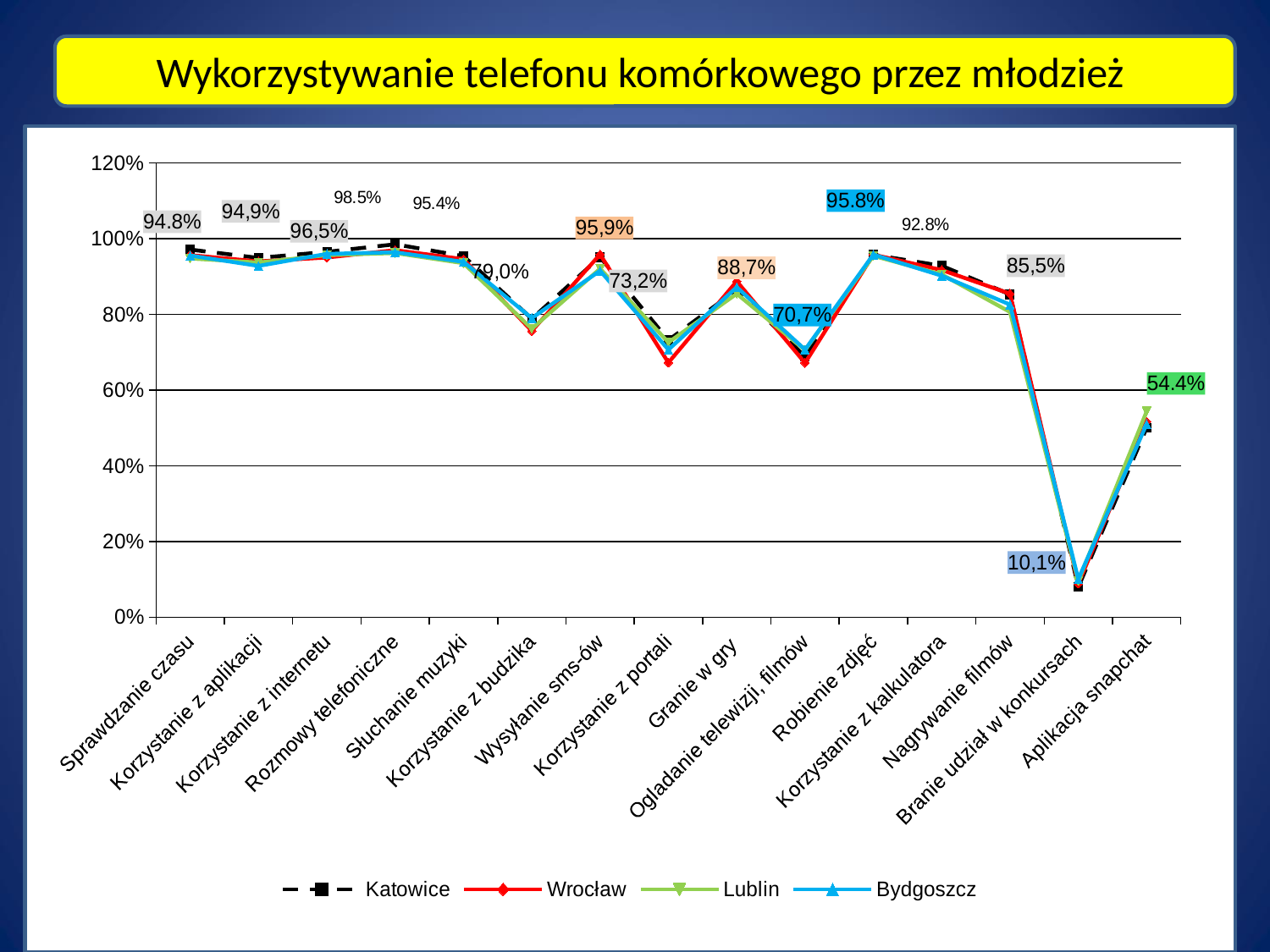
Is the value for Robienie zdjęć greater or less than 80%? greater What type of chart is shown on the slide? line chart Which series is drawn with a dashed black line? Katowice Which category has higher values, Sprawdzanie czasu or Branie udział w konkursach? Sprawdzanie czasu Is the value for Branie udział w konkursach greater or less than 20%? less What is the title of the chart? Wykorzystywanie telefonu komórkowego przez młodzież What data label is shown for Aplikacja snapchat? 54.4% Which category has the lowest values across all series? Branie udział w konkursach Is the value for Korzystanie z portali greater or less than 80%? less How many series does the legend list? 4 How many categories are shown on the x axis? 15